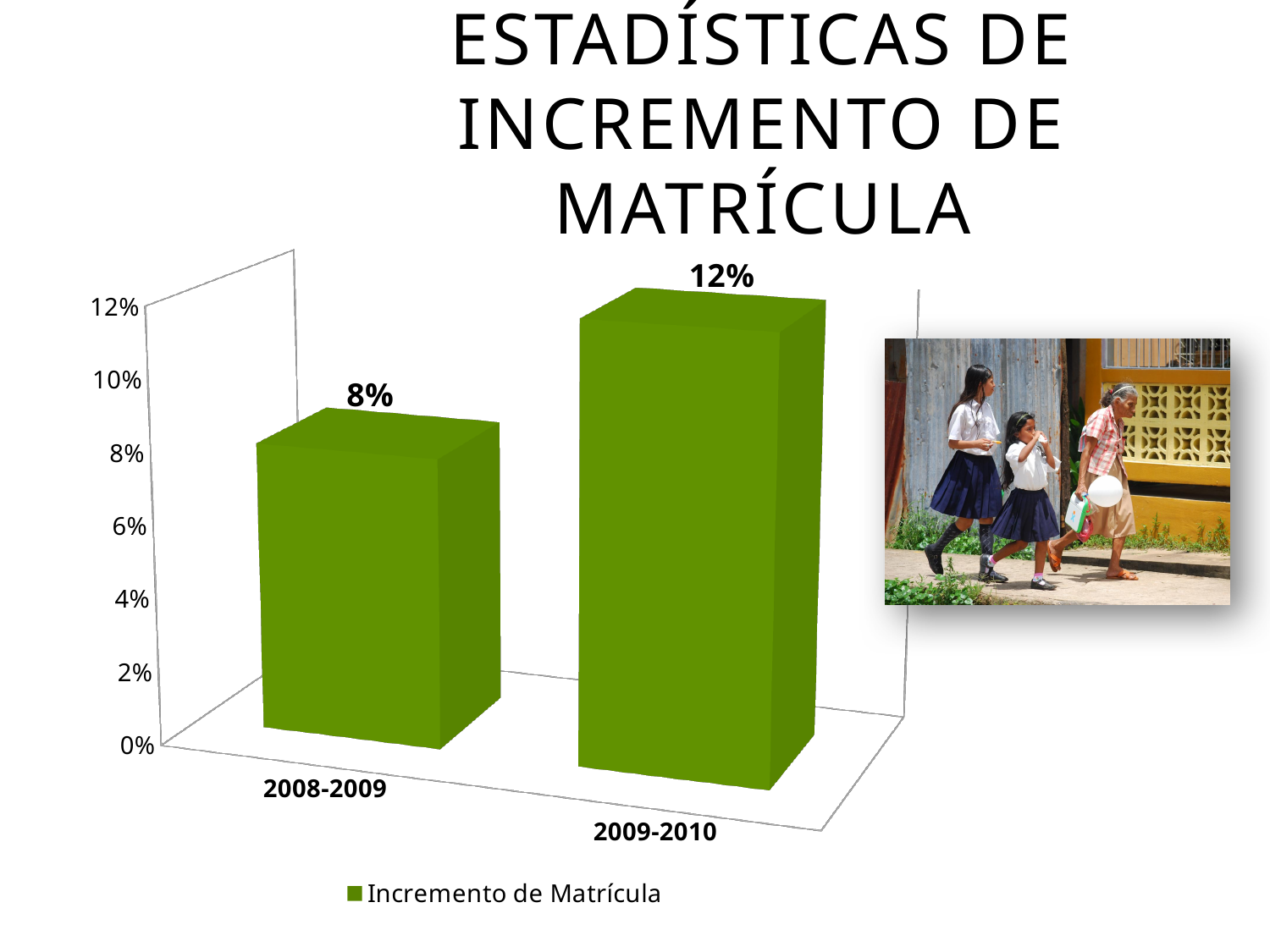
Which period has the highest value? 2009-2010 Is the value for 2008-2009 greater or less than 10%? less Which period has the lowest value? 2008-2009 How many series does the legend list? 1 What is the difference between the values for 2009-2010 and 2008-2009? 4% What is the value for 2009-2010? 12% What kind of chart is shown? bar chart Which is larger, the value for 2008-2009 or the value for 2009-2010? 2009-2010 What is the value for 2008-2009? 8% What is the name of the series in the legend? Incremento de Matrícula Is the value for 2009-2010 greater or less than 10%? greater How many categories are shown on the x axis? 2